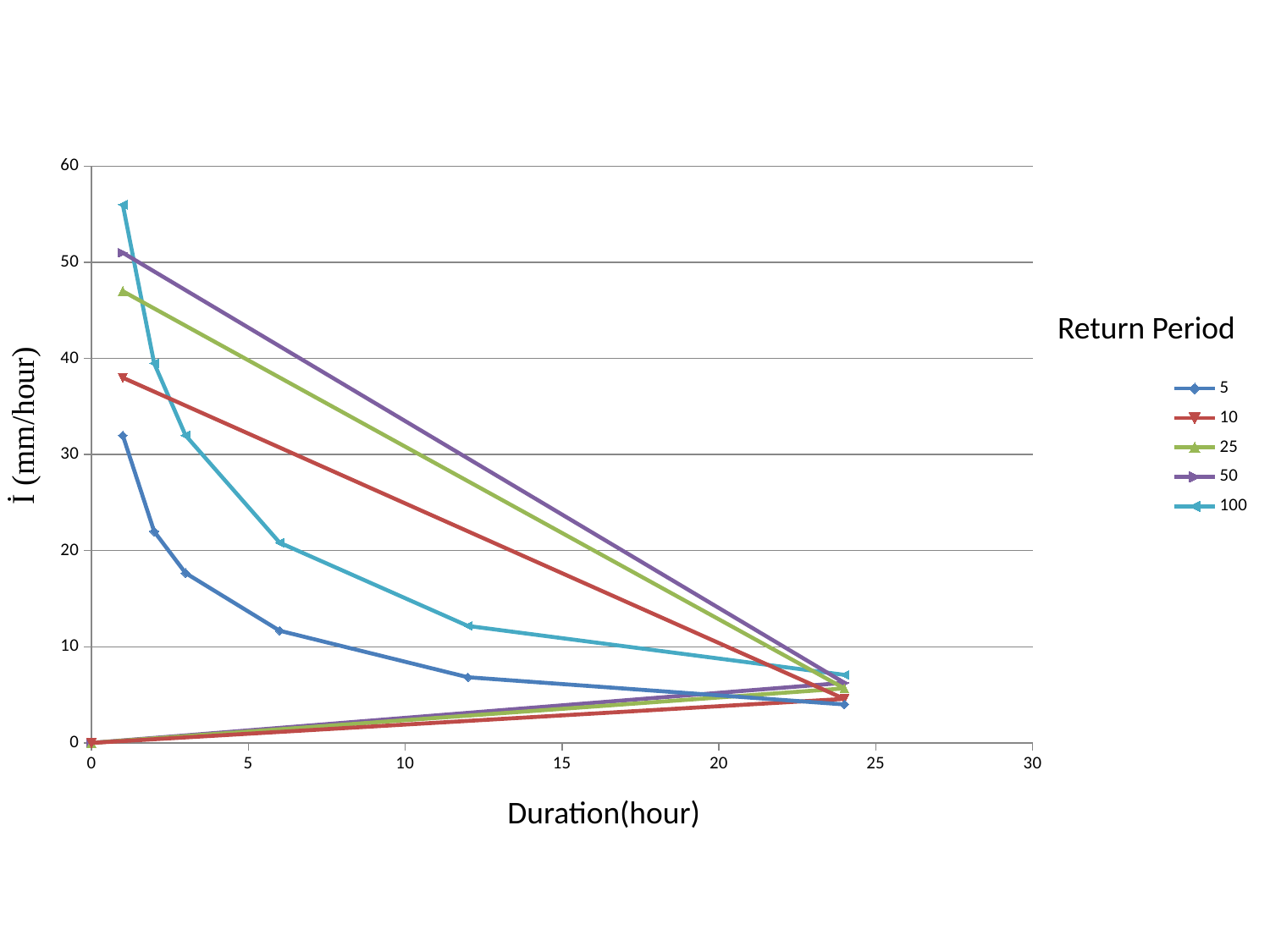
What is the title of the legend? Return Period Which series has the lowest value at a duration of 1 hour? 5 Is the value for the 10 series at a duration of 1 hour greater or less than 40? less Is the value for the 5 series at a duration of 1 hour greater or less than 30? greater Does the 5 series rise or fall as duration increases from 1 hour to 24 hours? fall What kind of chart is shown on the slide? line chart Is the value for the 25 series at a duration of 1 hour greater or less than 50? less What is the label of the x axis? Duration(hour) Which series has the highest value at a duration of 1 hour? 100 How many series does the legend list? 5